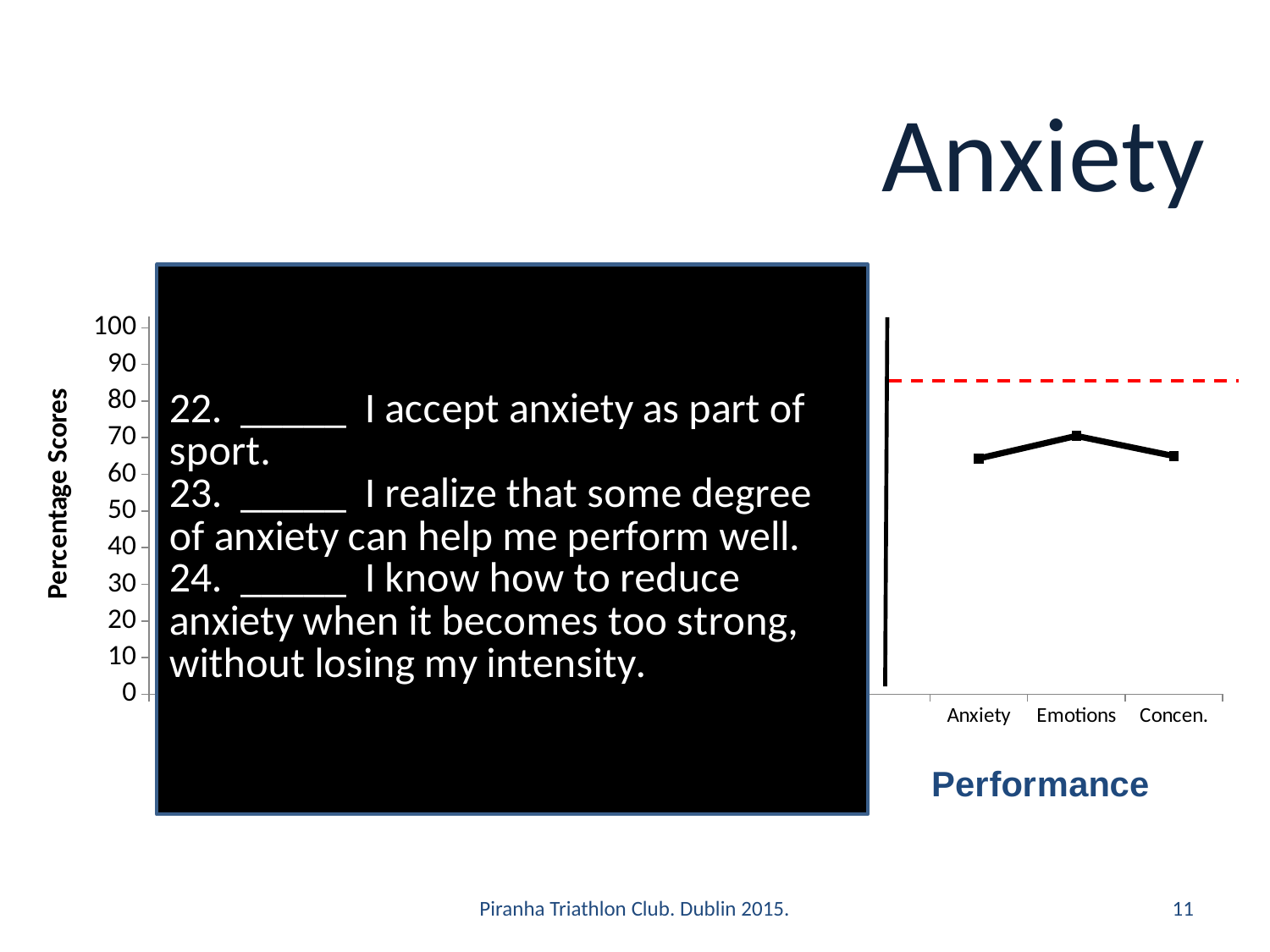
What kind of chart is shown on the slide? line chart Is the value for Emotions greater or less than 60? greater Which is larger, the value for Emotions or the value for Concen.? Emotions Is the value for Emotions greater or less than 80? less Is the value for Anxiety greater or less than 70? less What label appears below the category axis of the chart? Performance Which is larger, the value for Emotions or the value for Anxiety? Emotions What is the title of the vertical axis of the chart? Percentage Scores Of the visible categories Anxiety, Emotions and Concen., which has the highest value? Emotions